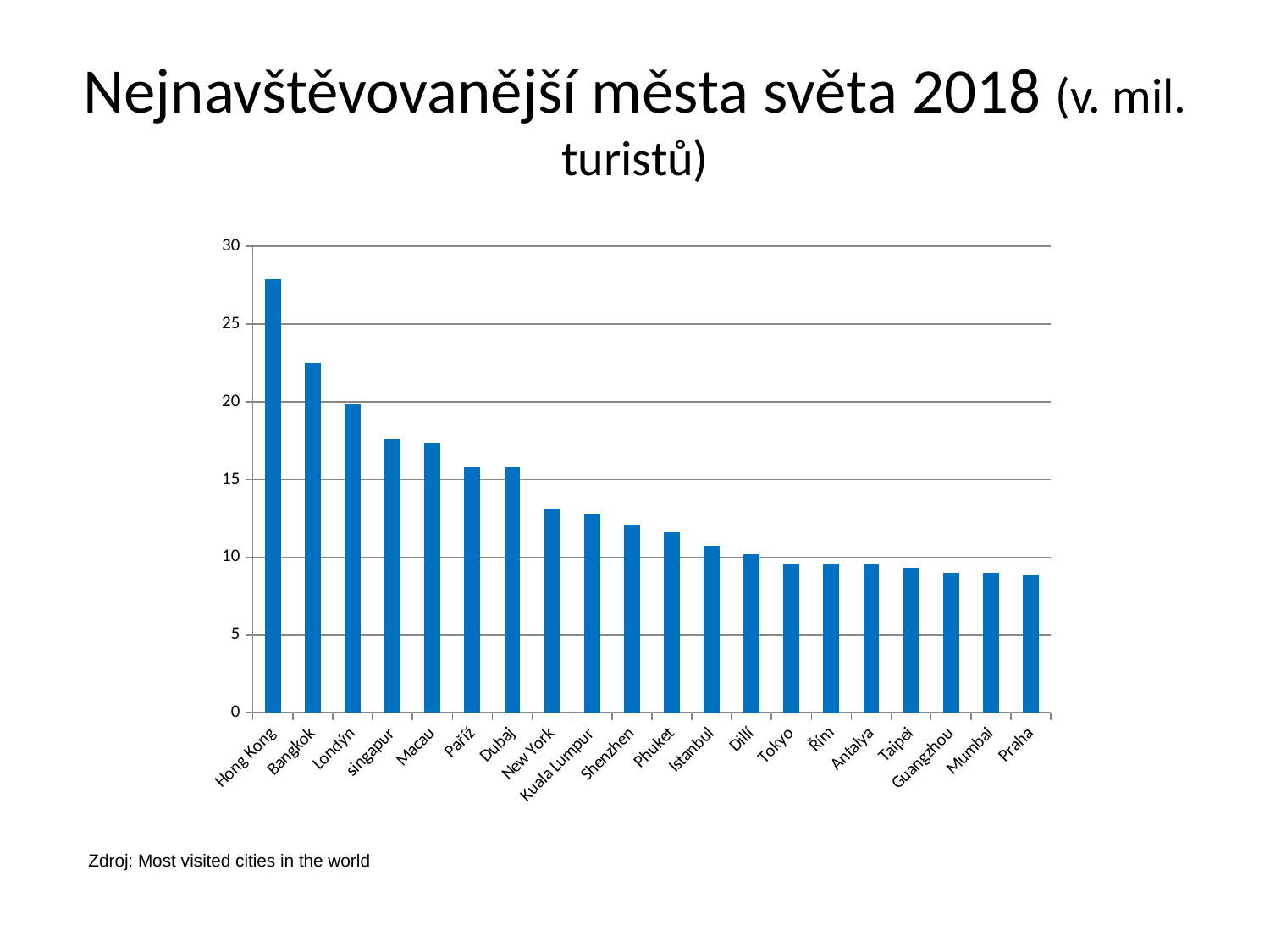
Is the value for New York greater or less than 15? less What is the title of the chart on the slide? Nejnavštěvovanější města světa 2018 (v. mil. turistů) Is the value for Hong Kong greater or less than 25? greater Do the values rise or fall from left to right along the x axis? fall Which city has the lowest value on the chart? Praha Which city has the highest value on the chart? Hong Kong Is the value for Praha greater or less than 10? less How many cities are shown on the chart? 20 Which has the larger value, Bangkok or Londýn? Bangkok What kind of chart is shown on the slide? bar chart